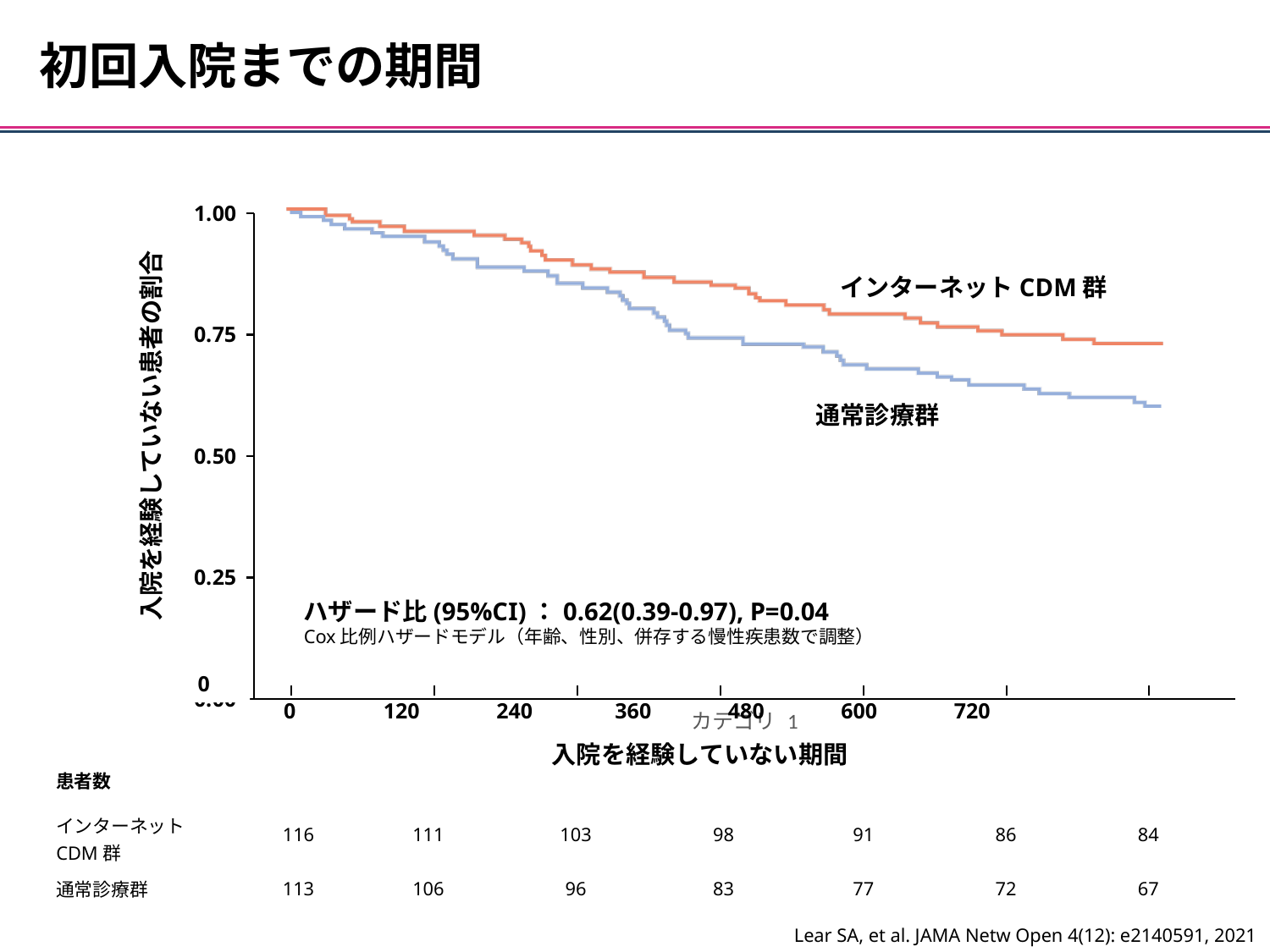
What hazard ratio (95%CI) is reported on the chart? 0.62(0.39-0.97), P=0.04 Is the value for 通常診療群 at x = 720 greater or less than 0.75? less Do the curves rise or fall as the x axis (入院を経験していない期間) increases? fall Which group is plotted with the orange line? インターネット CDM 群 How many groups (series) are plotted in the chart? 2 Is the value for インターネット CDM 群 at x = 360 greater or less than 0.75? greater Is the value for 通常診療群 at the end of the curve greater or less than 0.50? greater At x = 600, which group has the higher proportion of patients without hospitalization? インターネット CDM 群 What kind of chart is shown on the slide? line chart What is the title of the slide containing the chart? 初回入院までの期間 According to the patient-number table, how many patients were in the 通常診療群 at x = 360? 83 According to the patient-number table, how many patients were in the インターネット CDM 群 at x = 0? 116